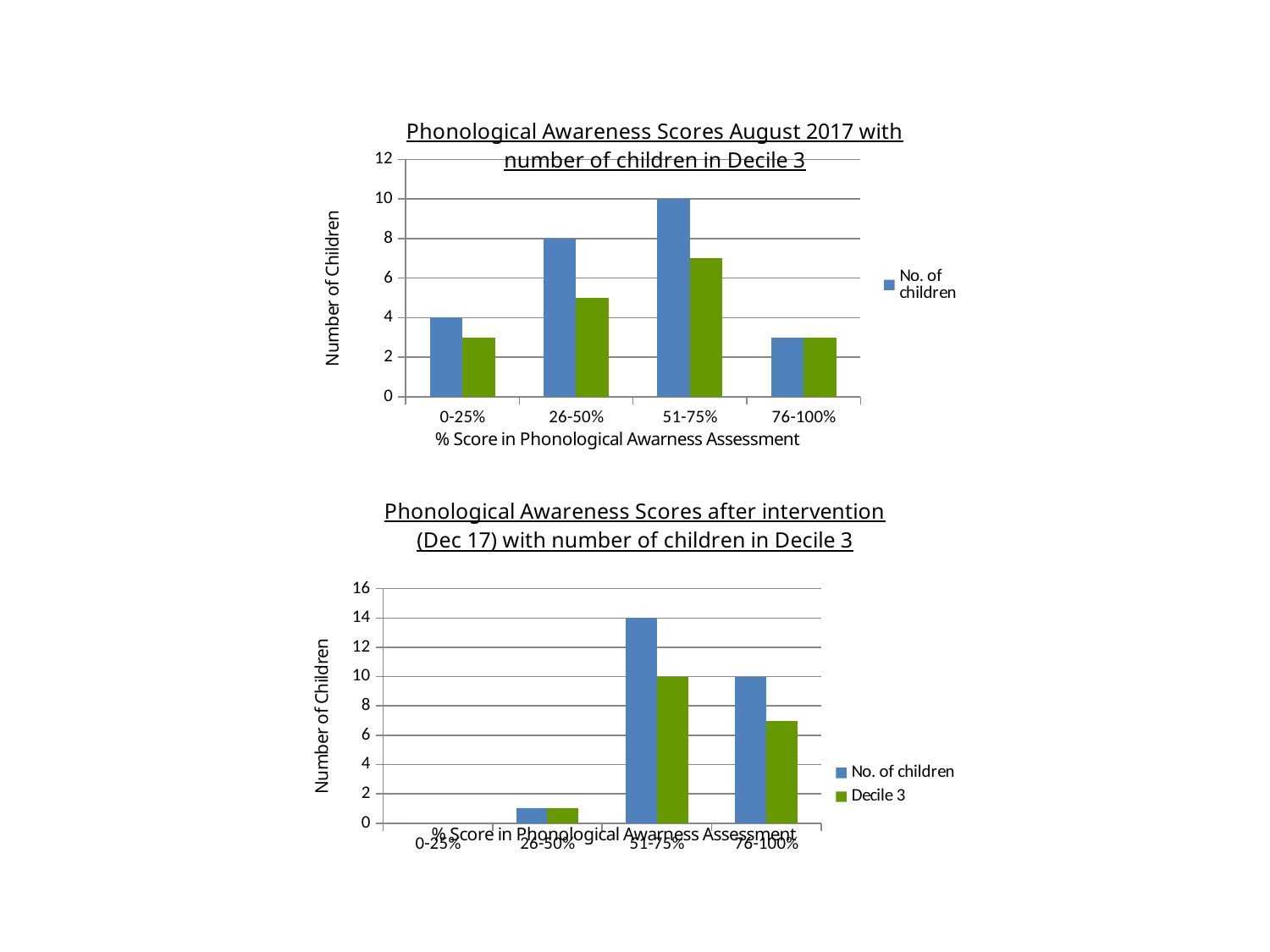
In the top chart (August 2017), what is the value of 'No. of children' for the 51-75% score band? 10 In the bottom chart (after intervention, Dec 17), what is the 'Decile 3' value for the 51-75% score band? 10 In the top chart (August 2017), which score band has the highest 'No. of children'? 51-75% How many series does the legend of the bottom chart (after intervention, Dec 17) list? 2 What kind of chart is the top chart, 'Phonological Awareness Scores August 2017 with number of children in Decile 3'? bar chart In the bottom chart (after intervention, Dec 17), which has the larger 'No. of children' value: the 51-75% band or the 76-100% band? 51-75% In the bottom chart (after intervention, Dec 17), what is the value of 'No. of children' for the 51-75% score band? 14 How many score bands are shown on the x axis of the top chart (August 2017)? 4 In the top chart (August 2017), what is the value of 'No. of children' for the 26-50% score band? 8 In the bottom chart (after intervention, Dec 17), is the 'Decile 3' value for the 76-100% band greater or less than 8? less In the top chart (August 2017), what is the difference between 'No. of children' for 51-75% and for 26-50%? 2 In the top chart (August 2017), is the green Decile 3 value for the 51-75% band greater or less than 6? greater